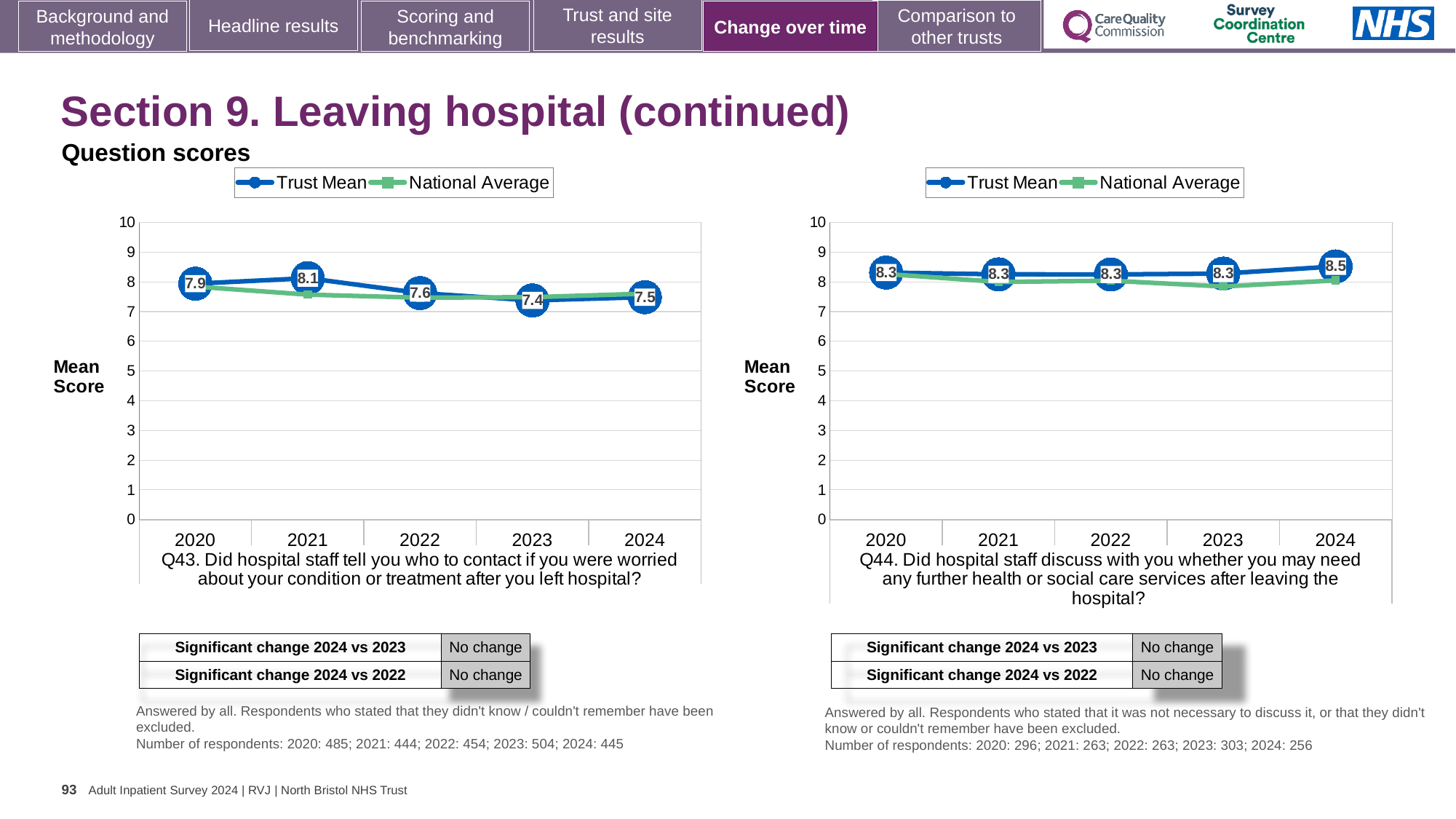
In the Q43 chart on the left, which year has the lowest Trust Mean score? 2023 Which is larger: the Trust Mean score for 2024 in the Q43 chart on the left or the Trust Mean score for 2024 in the Q44 chart on the right? Q44 chart (8.5) In the Q44 chart on the right, what is the difference between the Trust Mean scores for 2024 and 2023? 0.2 In the Q43 chart on the left, what is the Trust Mean score for 2023? 7.4 In the Q43 chart on the left, is the National Average value for 2021 greater or less than 8? less How many years are plotted on the x axis of the Q44 chart on the right? 5 In the Q44 chart on the right, which year has the highest Trust Mean score? 2024 In the Q43 chart on the left, what is the difference between the Trust Mean scores for 2021 and 2023? 0.7 In the Q43 chart on the left, which year has the highest Trust Mean score? 2021 What kind of chart is the Q43 chart on the left? Line chart In the Q44 chart on the right, what is the Trust Mean score for 2024? 8.5 In the Q43 chart on the left, what is the Trust Mean score for 2020? 7.9